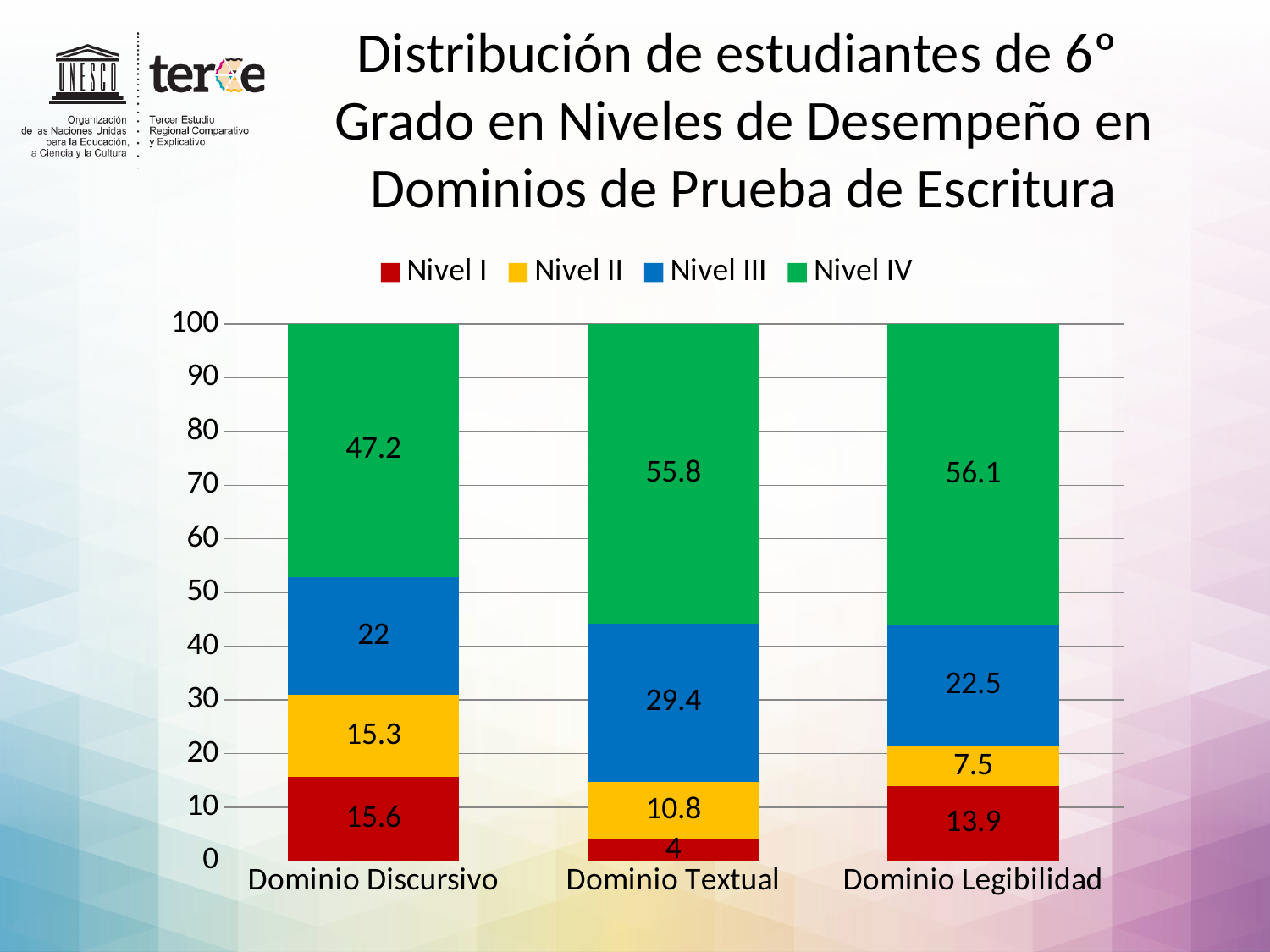
What is the Nivel III value for Dominio Textual? 29.4 What is the Nivel I value for Dominio Discursivo? 15.6 How many series does the legend list? 4 Which category has the lowest Nivel I value? Dominio Textual What is the Nivel IV value for Dominio Textual? 55.8 What is the difference between the Nivel III values for Dominio Textual and Dominio Discursivo? 7.4 What is the total of the stacked bar for Dominio Textual? 100 How many categories are shown on the x axis? 3 Which is larger: the Nivel II value for Dominio Discursivo or for Dominio Textual? Dominio Discursivo What is the Nivel II value for Dominio Legibilidad? 7.5 What kind of chart is shown on the slide? Stacked bar chart Which category has the highest Nivel IV value? Dominio Legibilidad